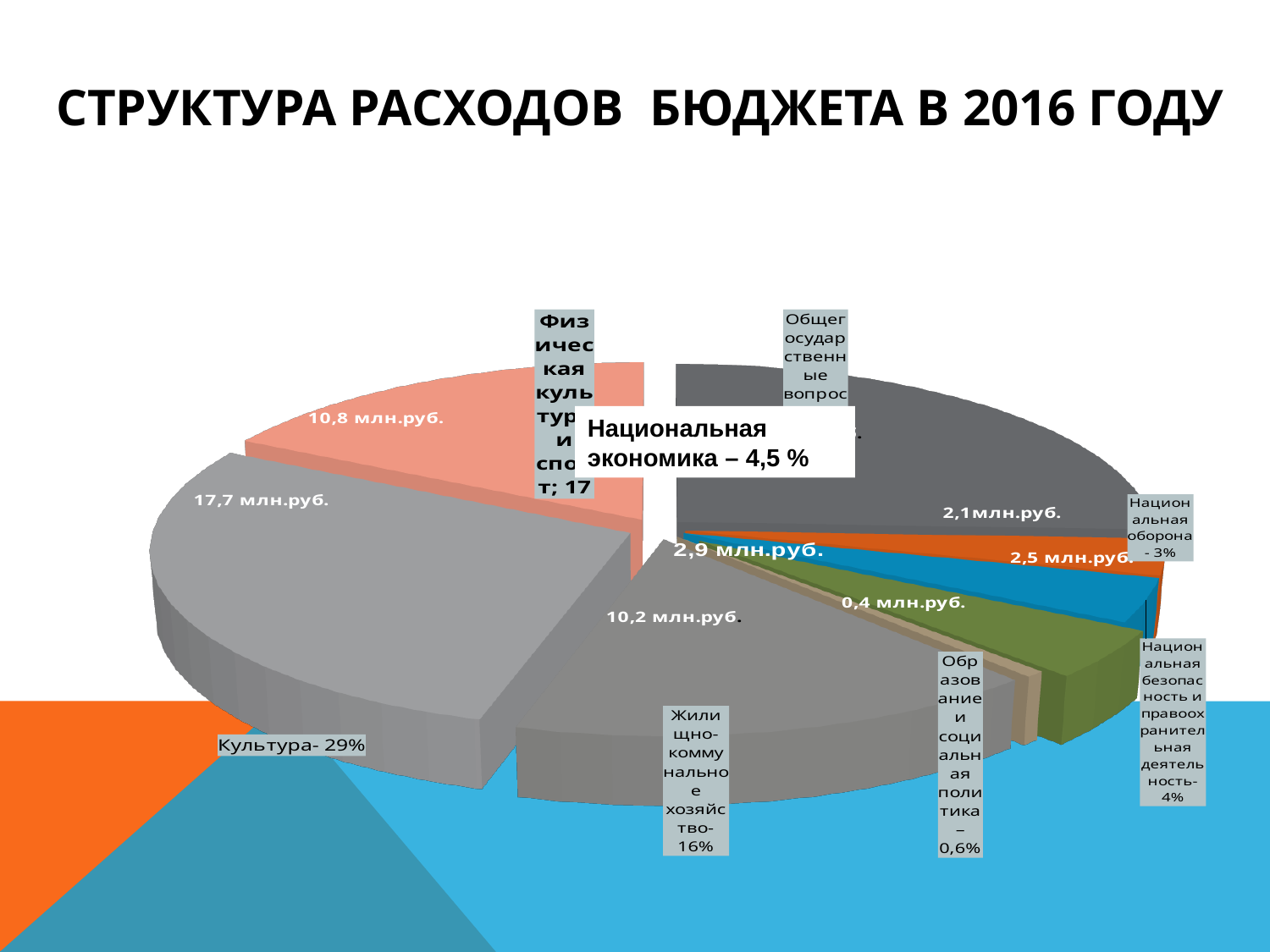
What share does Жилищно-коммунальное хозяйство account for? 16% What is the amount in млн.руб. shown on the Культура slice? 17,7 млн.руб. What share does Национальная безопасность и правоохранительная деятельность account for? 4% What share does Национальная оборона account for? 3% Which category has the smallest share of expenditure? Образование и социальная политика Which is larger: the share for Культура or for Жилищно-коммунальное хозяйство? Культура What kind of chart is shown on the slide? pie chart What is the title of the slide? СТРУКТУРА РАСХОДОВ БЮДЖЕТА В 2016 ГОДУ Which category has the largest share of expenditure? Культура